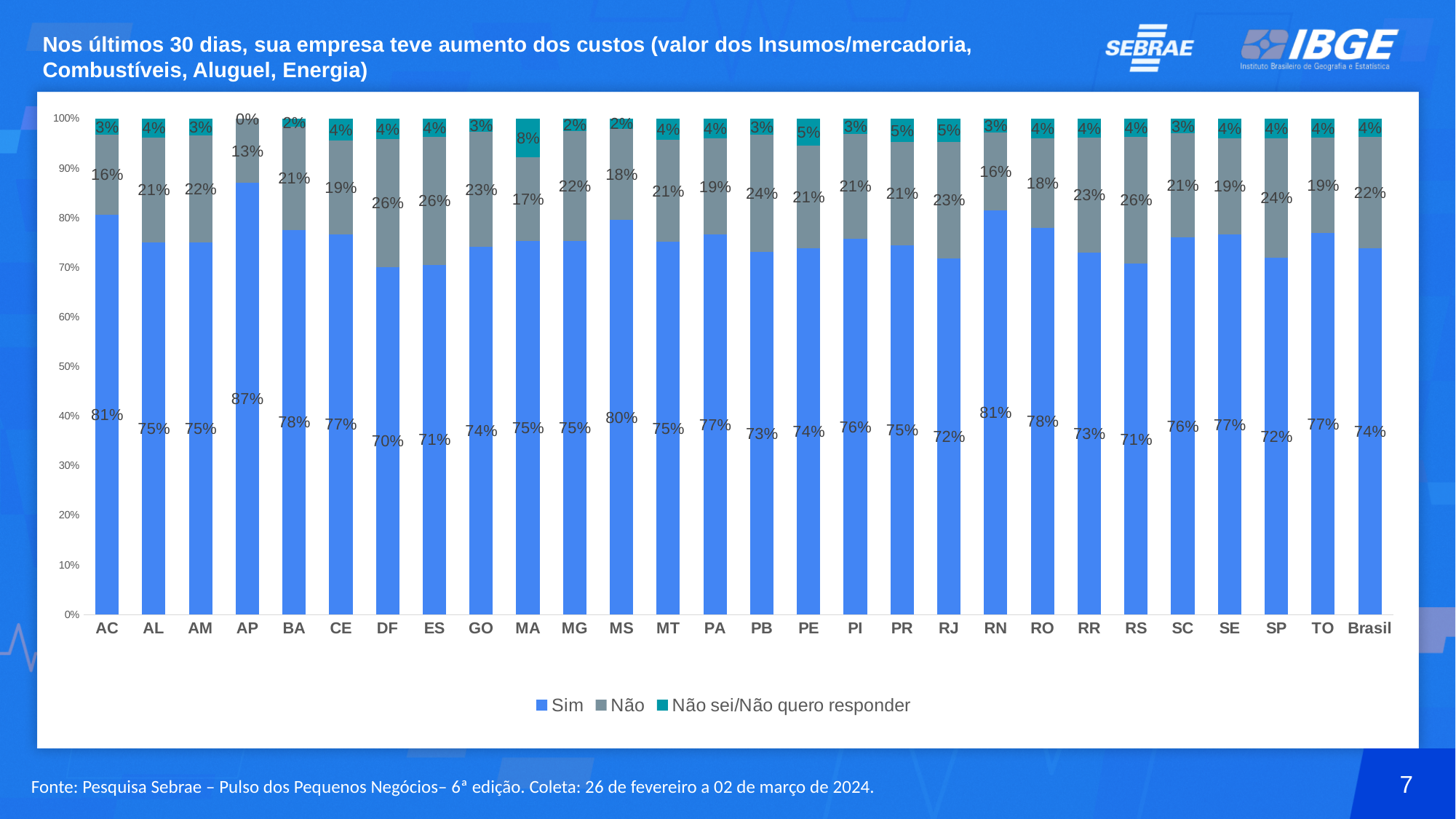
What is the difference between the "Sim" values for AP and DF? 17% Which category has the highest "Sim" value? AP Which category has the lowest "Sim" value? DF How many categories are shown on the x axis? 28 What percentage of respondents in AP answered "Sim"? 87% What kind of chart is shown on the slide? Stacked bar chart Which category has the lowest "Não" value? AP What is the "Sim" value for Brasil? 74% What is the "Não" value for DF? 26% How many series does the legend list? 3 Which has a larger "Sim" value, RN or RJ? RN What is the "Não sei/Não quero responder" value for MA? 8%